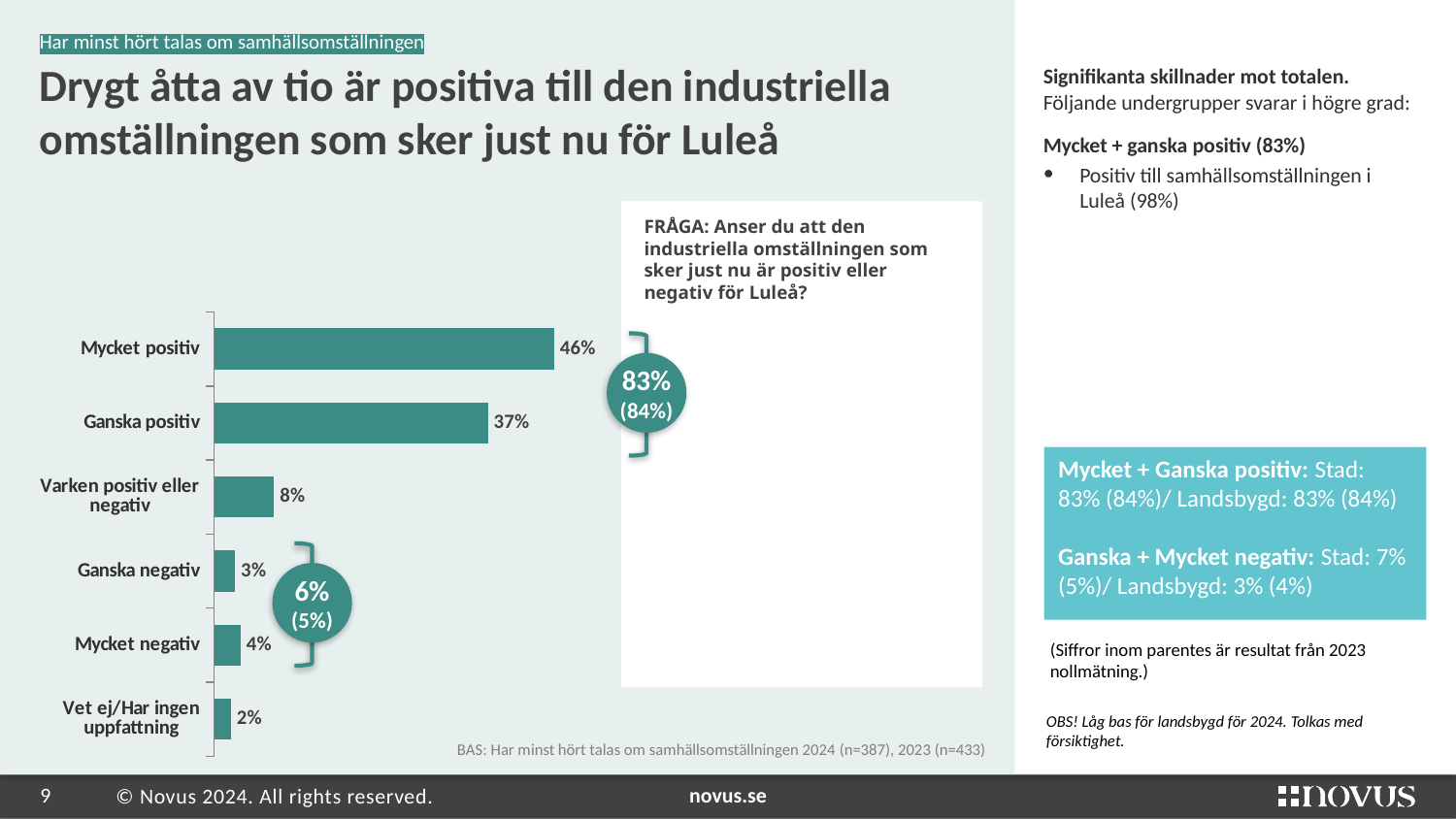
Which is larger, 'Ganska negativ' or 'Mycket negativ'? Mycket negativ What combined value is shown in the circle next to 'Mycket positiv' and 'Ganska positiv'? 83% (84%) What combined value is shown in the circle next to 'Ganska negativ' and 'Mycket negativ'? 6% (5%) Which category has the highest value? Mycket positiv How many categories are shown in the bar chart? 6 What is the value for 'Ganska positiv'? 37% What kind of chart is shown on the slide? Bar chart What is the value for 'Vet ej/Har ingen uppfattning'? 2% What is the difference between 'Mycket positiv' and 'Ganska positiv'? 9 percentage points What percentage of respondents answered 'Mycket positiv'? 46% Which category has the lowest value? Vet ej/Har ingen uppfattning What is the value for 'Varken positiv eller negativ'? 8%